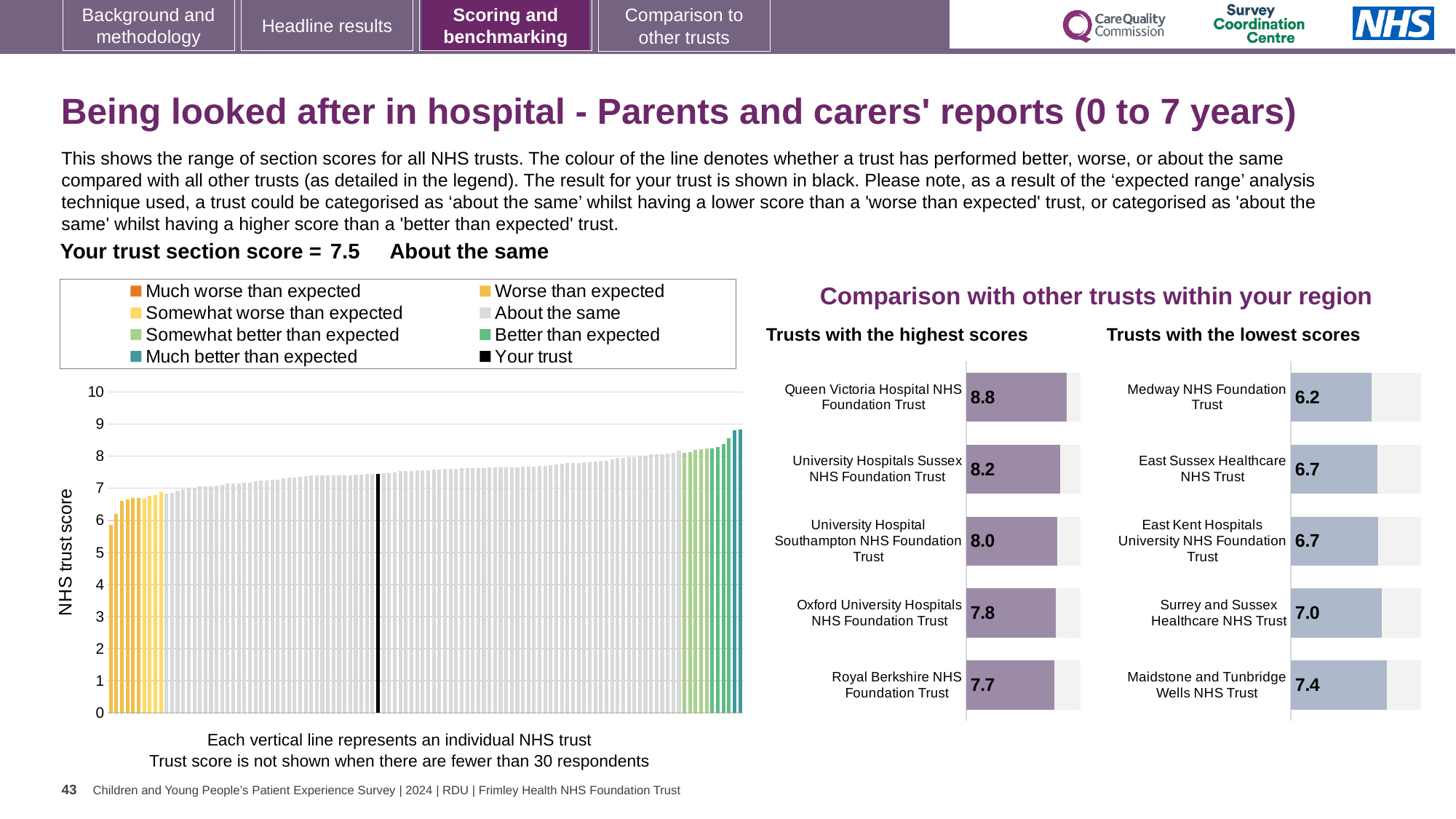
In the 'Trusts with the highest scores' chart, what is the score for Queen Victoria Hospital NHS Foundation Trust? 8.8 What kind of chart is the large chart on the left with the 'NHS trust score' axis? Bar chart In the 'Trusts with the highest scores' chart, which has the larger score: University Hospitals Sussex NHS Foundation Trust or Oxford University Hospitals NHS Foundation Trust? University Hospitals Sussex NHS Foundation Trust In the 'Trusts with the lowest scores' chart, what is the score for Medway NHS Foundation Trust? 6.2 In the 'Trusts with the highest scores' chart, what is the difference between the scores of Queen Victoria Hospital NHS Foundation Trust and Royal Berkshire NHS Foundation Trust? 1.1 In the 'Trusts with the lowest scores' chart, which trust has the highest score shown? Maidstone and Tunbridge Wells NHS Trust In the 'Trusts with the lowest scores' chart, what score is shown for Surrey and Sussex Healthcare NHS Trust? 7.0 In the 'Trusts with the highest scores' chart, which trust has the lowest score shown? Royal Berkshire NHS Foundation Trust In the large 'NHS trust score' chart on the left, do the bar values rise or fall from left to right? Rise How many trusts are listed in the 'Trusts with the lowest scores' chart? 5 In the 'Trusts with the lowest scores' chart, what is the difference between the scores of Maidstone and Tunbridge Wells NHS Trust and Medway NHS Foundation Trust? 1.2 How many entries does the legend above the 'NHS trust score' chart list? 8